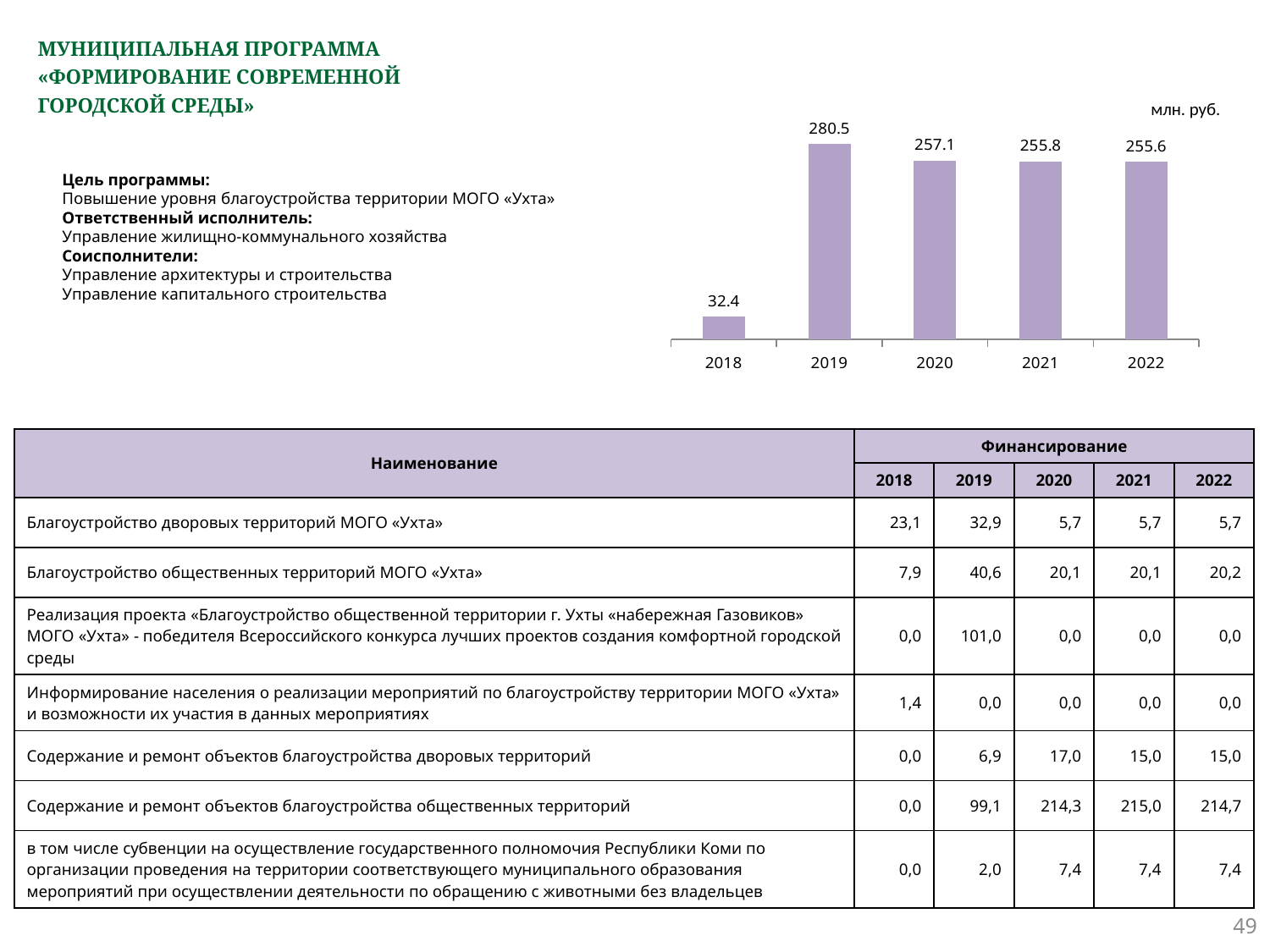
What is the value for 2018 on the bar chart? 32.4 What kind of chart is shown on the slide? bar chart What is the difference between the values for 2019 and 2020 on the bar chart? 23.4 What is the value for 2022 on the bar chart? 255.6 What is the value for 2019 on the bar chart? 280.5 Which is larger on the bar chart, the value for 2019 or the value for 2021? 2019 What unit is indicated for the values on the bar chart? млн. руб. What is the value for 2020 on the bar chart? 257.1 Which year has the highest value on the bar chart? 2019 How many years are shown on the bar chart? 5 What is the difference between the values for 2019 and 2018 on the bar chart? 248.1 Which year has the lowest value on the bar chart? 2018